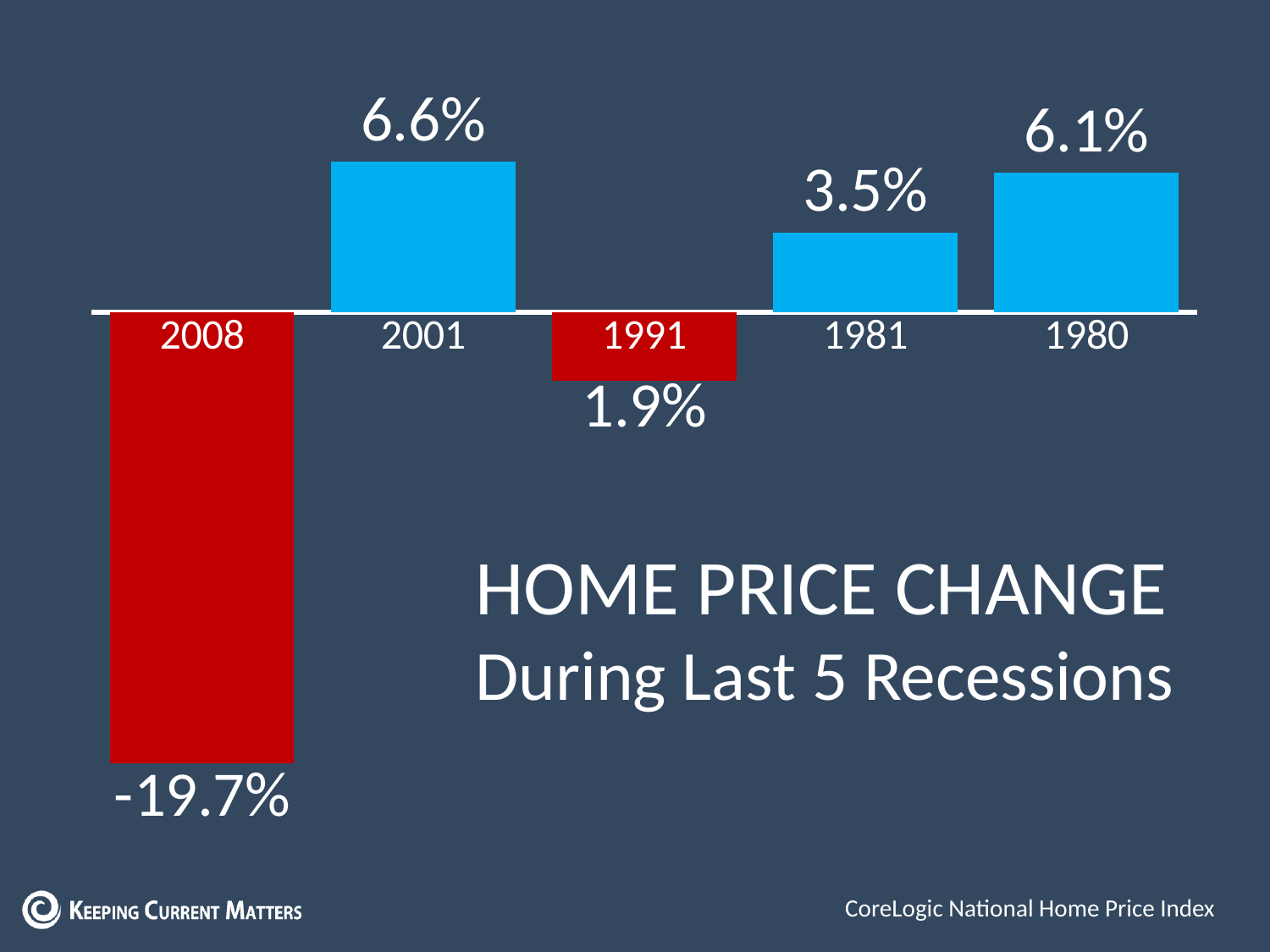
What is the home price change shown for the 1981 recession? 3.5% Which has the larger home price change, 1981 or 1980? 1980 Which recession year has the highest home price change? 2001 What is the home price change shown for the 1980 recession? 6.1% What is the difference between the home price change for 2001 and for 1980? 0.5% What is the difference between the home price change for 2001 and for 1981? 3.1% Which recession year has the lowest home price change? 2008 How many recession years are shown in the chart? 5 What data source is cited for the chart? CoreLogic National Home Price Index What is the home price change shown for the 2008 recession? -19.7% What is the home price change shown for the 2001 recession? 6.6% What kind of chart is shown on the slide? Bar chart